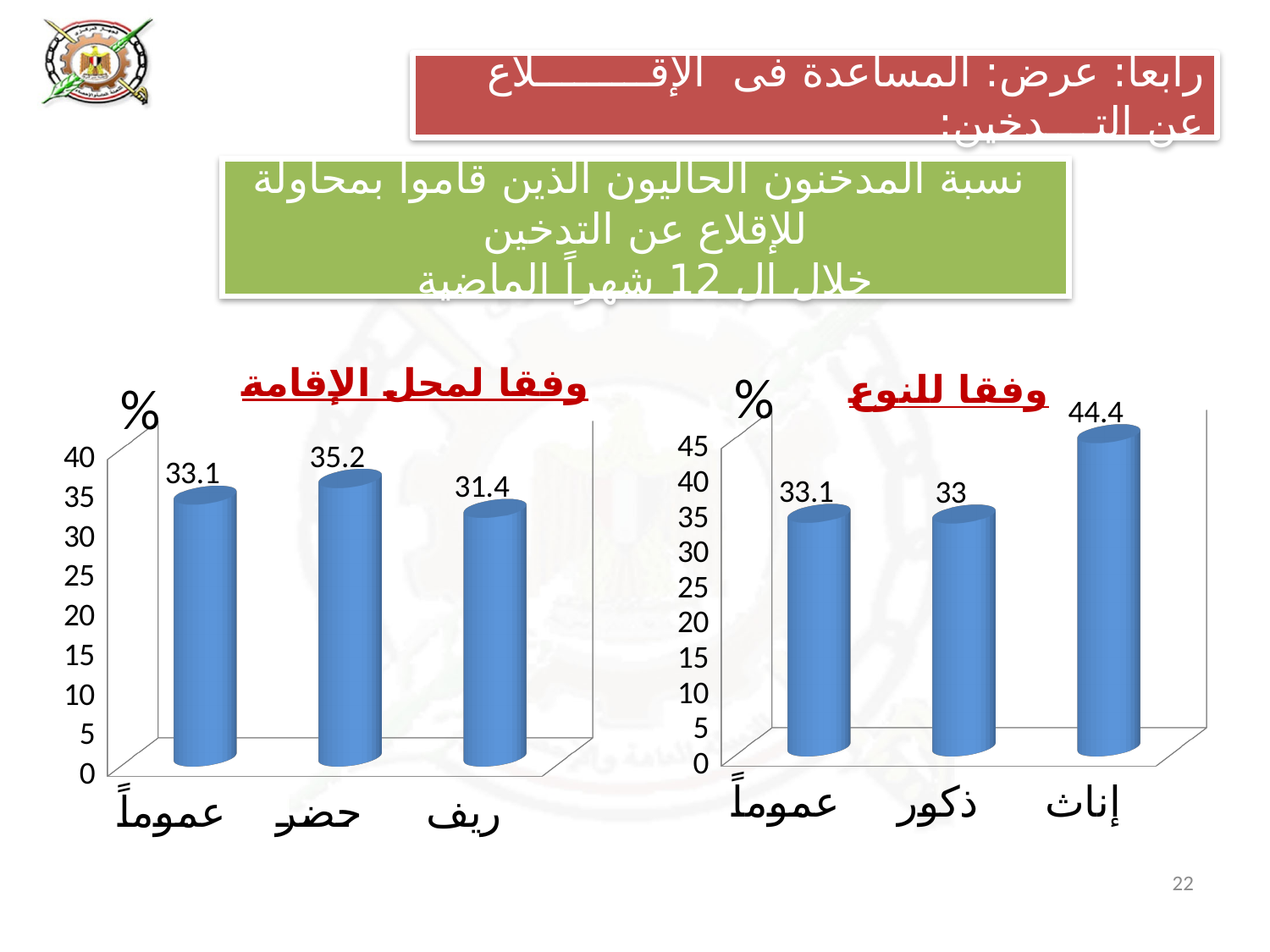
In the chart titled وفقا لمحل الإقامة, how many categories are shown? 3 In the chart titled وفقا لمحل الإقامة, what is the value for ريف? 31.4 In the chart titled وفقا لمحل الإقامة, which category has the lowest value? ريف In the chart titled وفقا للنوع, what is the value for ذكور? 33 In the chart titled وفقا لمحل الإقامة, what is the value for حضر? 35.2 In the chart titled وفقا لمحل الإقامة, which category has the highest value? حضر In the chart titled وفقا للنوع, what is the difference between the values for إناث and ذكور? 11.4 In the chart titled وفقا للنوع, which category has the highest value? إناث What kind of chart is the chart titled وفقا للنوع? bar chart In the chart titled وفقا لمحل الإقامة, what is the difference between the values for حضر and ريف? 3.8 In the chart titled وفقا للنوع, what is the value for إناث? 44.4 In the chart titled وفقا للنوع, is the value for إناث greater or less than 40? greater